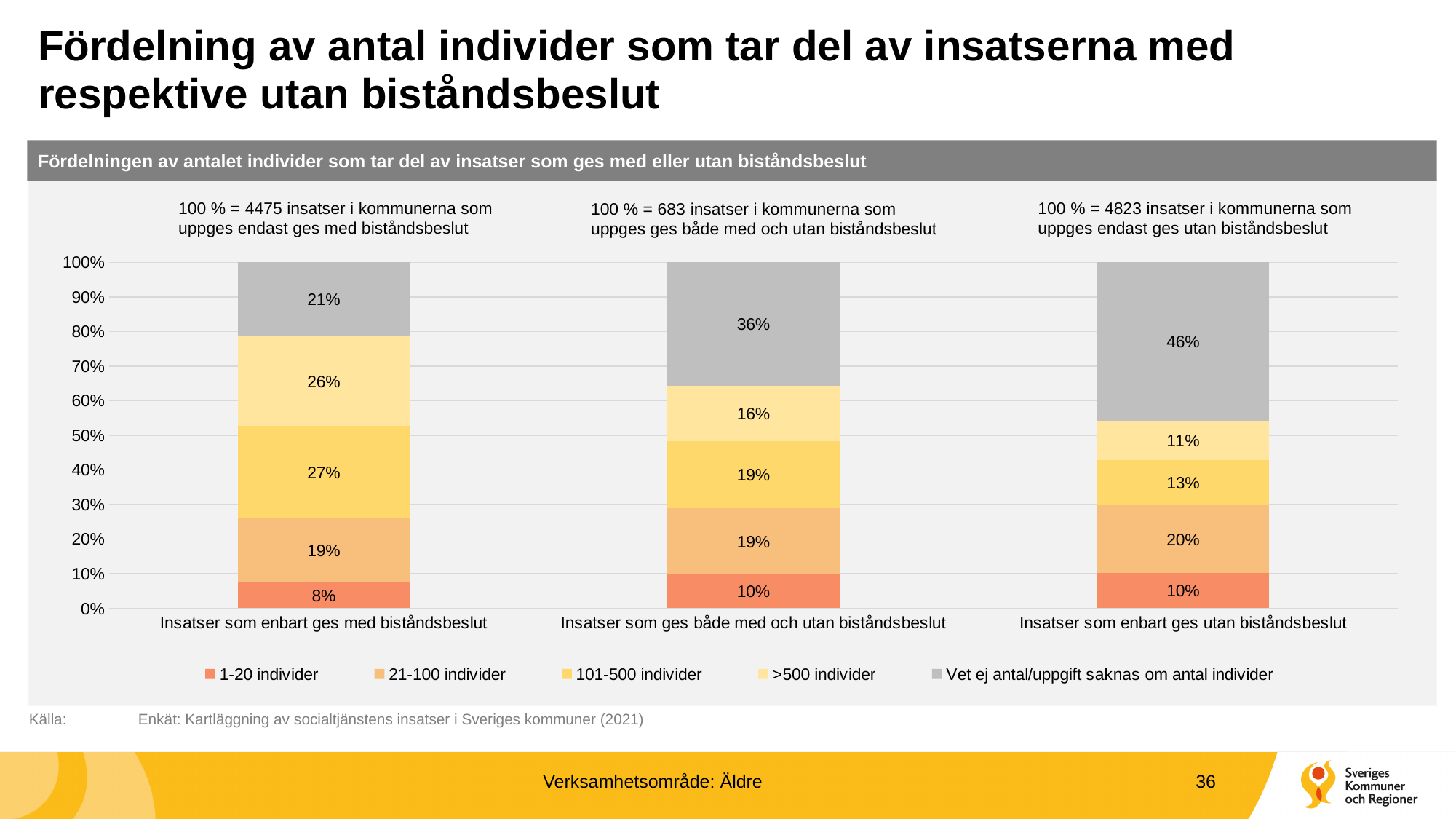
What is the value for '>500 individer' in the category 'Insatser som enbart ges med biståndsbeslut'? 26% What is the value for '101-500 individer' in the category 'Insatser som ges både med och utan biståndsbeslut'? 19% What is the value for '1-20 individer' in the category 'Insatser som enbart ges med biståndsbeslut'? 8% How many categories are shown on the x axis of the chart? 3 What kind of chart is shown on the slide? Stacked bar chart Which category has the highest value for 'Vet ej antal/uppgift saknas om antal individer'? Insatser som enbart ges utan biståndsbeslut How many series does the legend list? 5 Which category has the lowest value for '>500 individer'? Insatser som enbart ges utan biståndsbeslut What is the difference between the '101-500 individer' values for 'Insatser som enbart ges med biståndsbeslut' and 'Insatser som enbart ges utan biståndsbeslut'? 14% According to the annotation above the chart, how many insatser does 100 % correspond to for the category 'Insatser som ges både med och utan biståndsbeslut'? 683 Which is larger: the '21-100 individer' value for 'Insatser som enbart ges utan biståndsbeslut' or for 'Insatser som enbart ges med biståndsbeslut'? Insatser som enbart ges utan biståndsbeslut What is the value for 'Vet ej antal/uppgift saknas om antal individer' in the category 'Insatser som enbart ges utan biståndsbeslut'? 46%